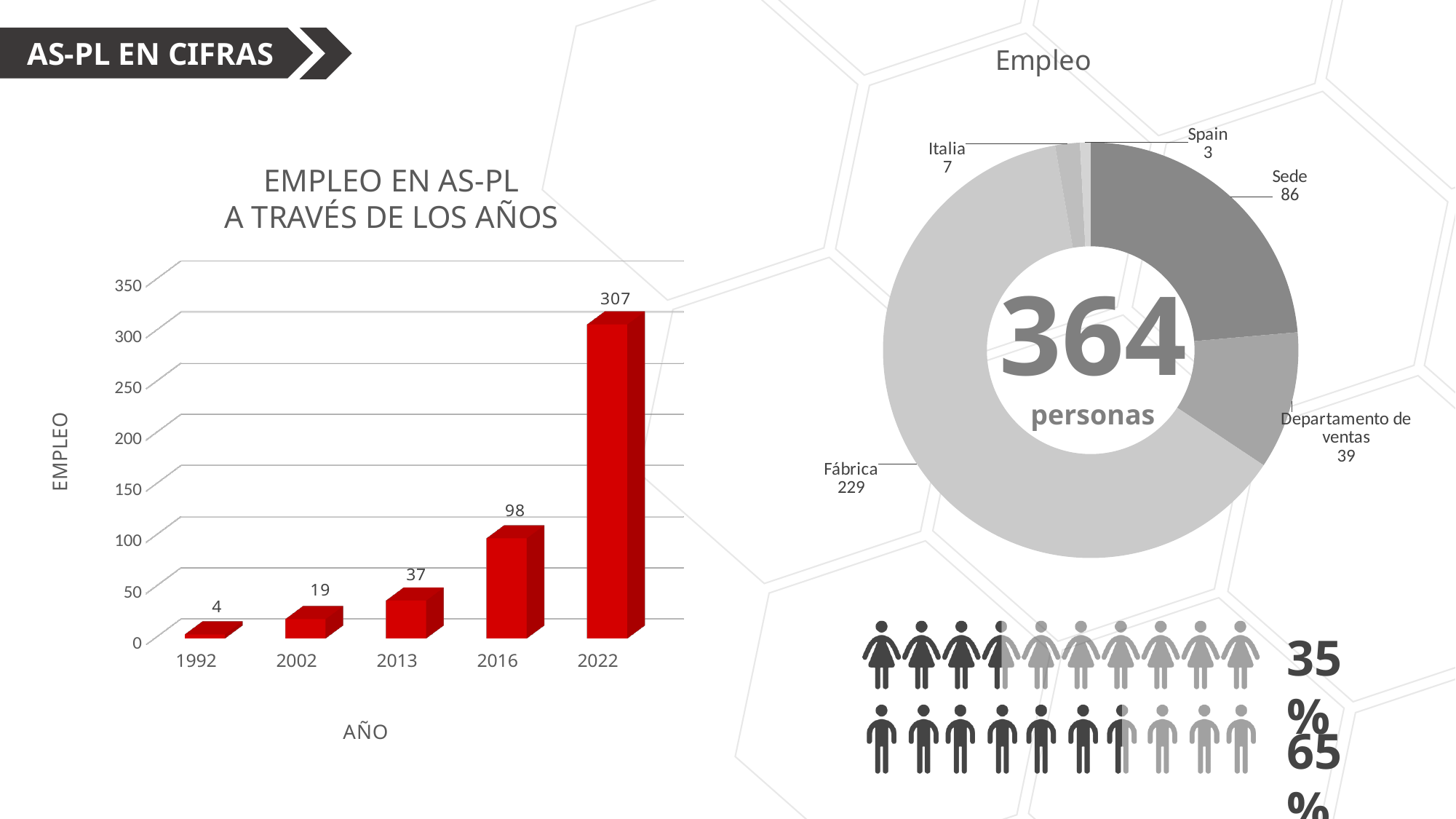
What kind of chart is 'EMPLEO EN AS-PL A TRAVÉS DE LOS AÑOS'? bar chart In the 'EMPLEO EN AS-PL A TRAVÉS DE LOS AÑOS' chart, what is the value for 2022? 307 In the 'Empleo' chart, how many categories are shown? 5 In the 'Empleo' chart, which category has the largest value? Fábrica In the 'EMPLEO EN AS-PL A TRAVÉS DE LOS AÑOS' chart, which year has the lowest value? 1992 In the 'EMPLEO EN AS-PL A TRAVÉS DE LOS AÑOS' chart, what is the difference between the values for 2022 and 2016? 209 In the 'EMPLEO EN AS-PL A TRAVÉS DE LOS AÑOS' chart, how many years are shown on the x axis? 5 In the 'Empleo' chart, what is the value for Fábrica? 229 In the 'Empleo' chart, which is larger, Sede or Italia? Sede In the 'EMPLEO EN AS-PL A TRAVÉS DE LOS AÑOS' chart, do the values rise or fall from 1992 to 2022? rise In the 'Empleo' chart, what is the value for Departamento de ventas? 39 In the 'EMPLEO EN AS-PL A TRAVÉS DE LOS AÑOS' chart, what is the value for 2013? 37